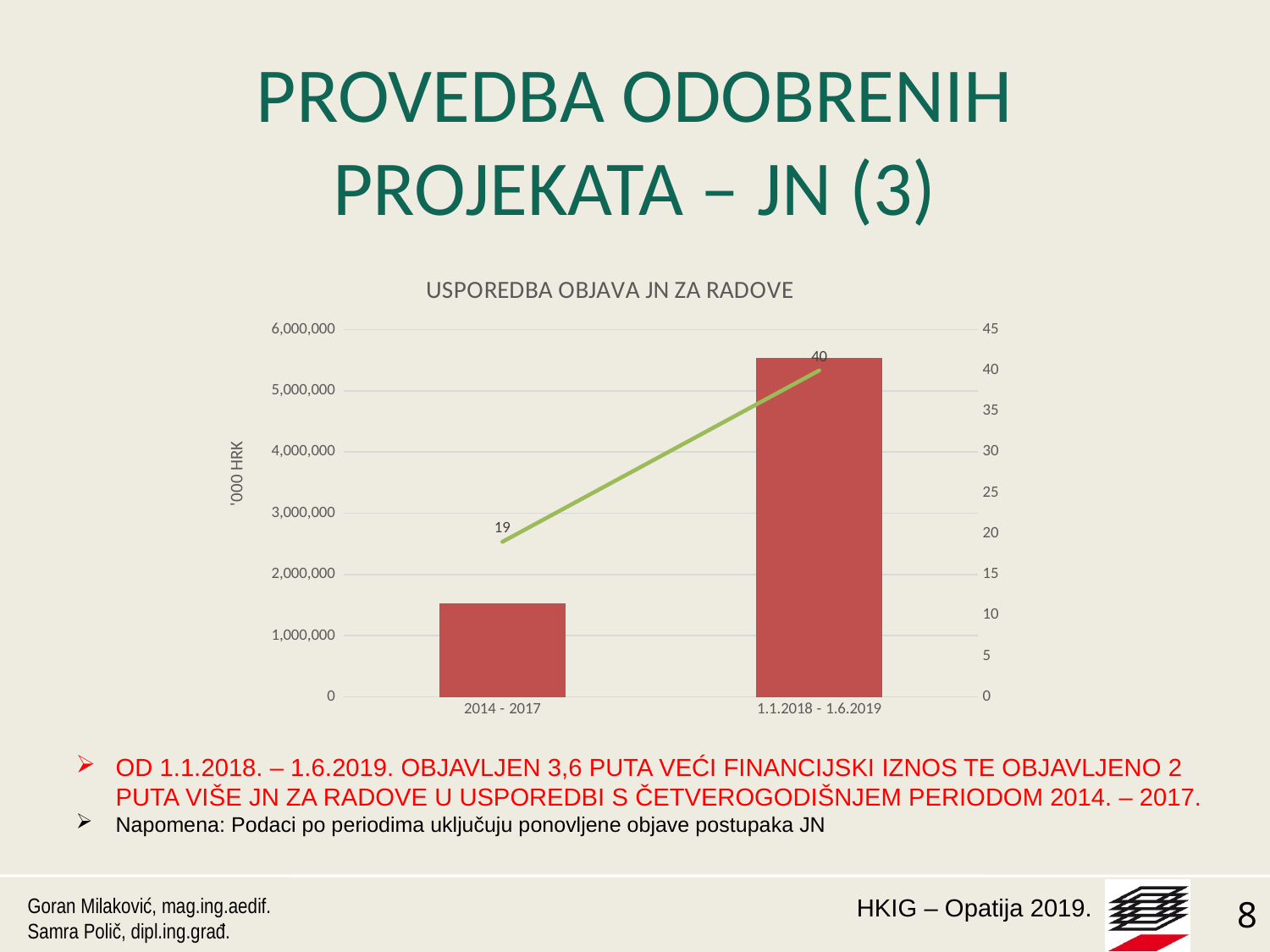
What value does the line show for the period 2014 - 2017? 19 What value does the line show for the period 1.1.2018 - 1.6.2019? 40 Which period has the taller bar? 1.1.2018 - 1.6.2019 Is the bar value for 2014 - 2017 greater or less than 1,000,000? greater How many periods (categories) are shown on the x axis? 2 What unit is shown on the left vertical axis label? '000 HRK Which period has the shorter bar? 2014 - 2017 What is the difference between the line values for 1.1.2018 - 1.6.2019 and 2014 - 2017? 21 Does the line rise or fall from 2014 - 2017 to 1.1.2018 - 1.6.2019? rise Is the bar value for 2014 - 2017 greater or less than 2,000,000? less What is the title of the chart? USPOREDBA OBJAVA JN ZA RADOVE Is the bar value for 1.1.2018 - 1.6.2019 greater or less than 5,000,000? greater